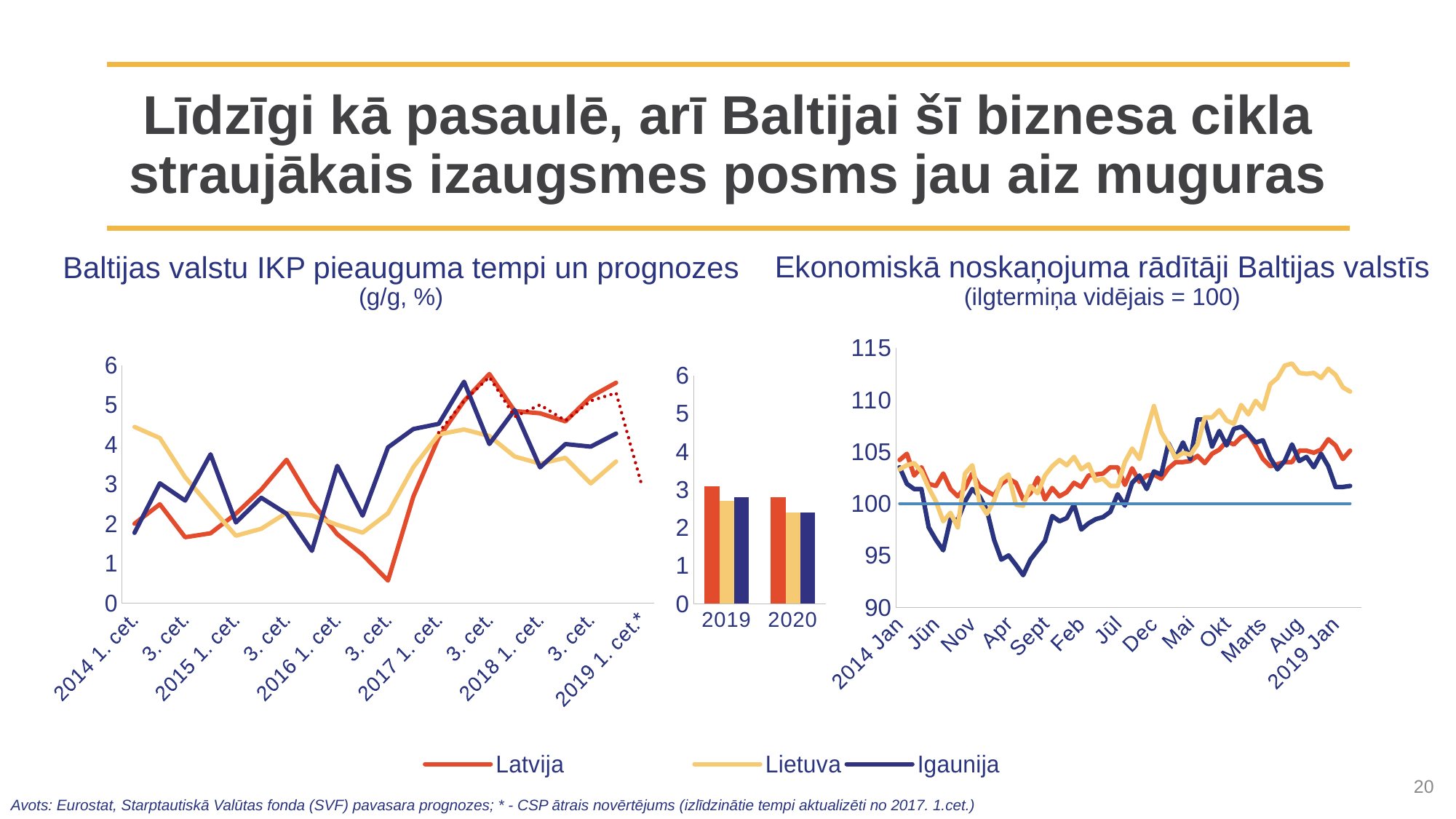
In the middle bar chart, is the value for Latvija in 2020 greater or less than 3? less How many categories are shown on the x axis of the middle bar chart? 2 In the middle bar chart, which is larger for 2019: Latvija or Lietuva? Latvija In the right chart 'Ekonomiskā noskaņojuma rādītāji Baltijas valstīs', is the lowest value of Igaunija greater or less than 95? less In the left chart, is the value for Latvija at 2016 3. cet. greater or less than 1? less In the right chart 'Ekonomiskā noskaņojuma rādītāji Baltijas valstīs', which country reaches the highest value over the period shown? Lietuva In the middle bar chart, which country has the highest value for 2019? Latvija How many series does the legend at the bottom of the slide list? 3 What kind of chart is the middle chart showing 2019 and 2020? bar chart What kind of chart is the left chart titled 'Baltijas valstu IKP pieauguma tempi un prognozes'? line chart